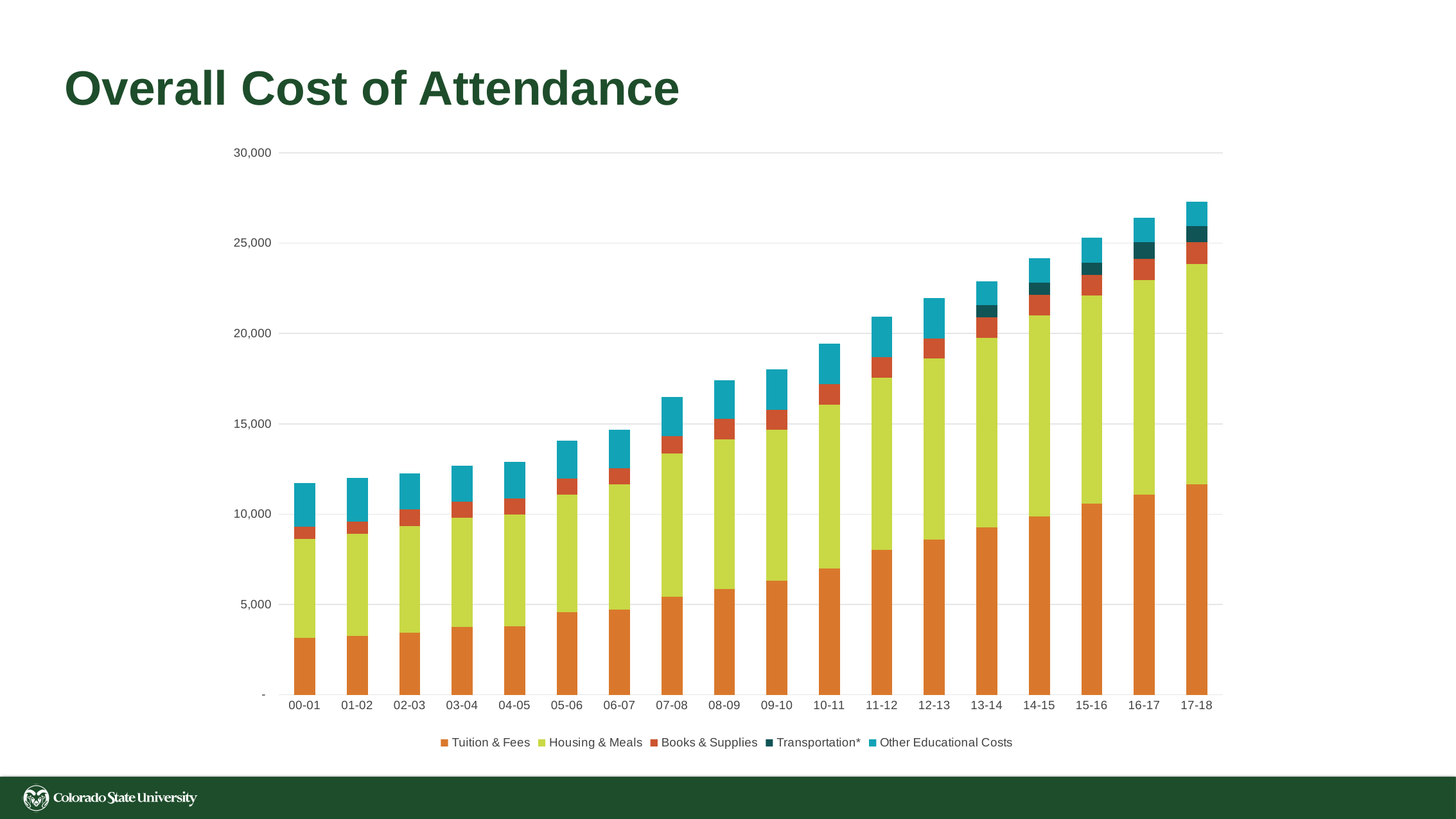
Is the total cost of attendance for 00-01 greater or less than 10,000? greater Do the total bar heights rise or fall from 00-01 to 17-18? Rise How many academic years are shown on the x axis of the chart? 18 Which is larger, the total cost of attendance for 17-18 or for 00-01? 17-18 Is the total cost of attendance for 17-18 greater or less than 25,000? greater Is the Tuition & Fees value for 17-18 greater or less than 10,000? greater How many series does the legend of the chart list? 5 Which academic year has the highest total cost of attendance? 17-18 What kind of chart is shown on the slide? Stacked bar chart Which academic year has the lowest total cost of attendance? 00-01 What is the title of the chart on the slide? Overall Cost of Attendance